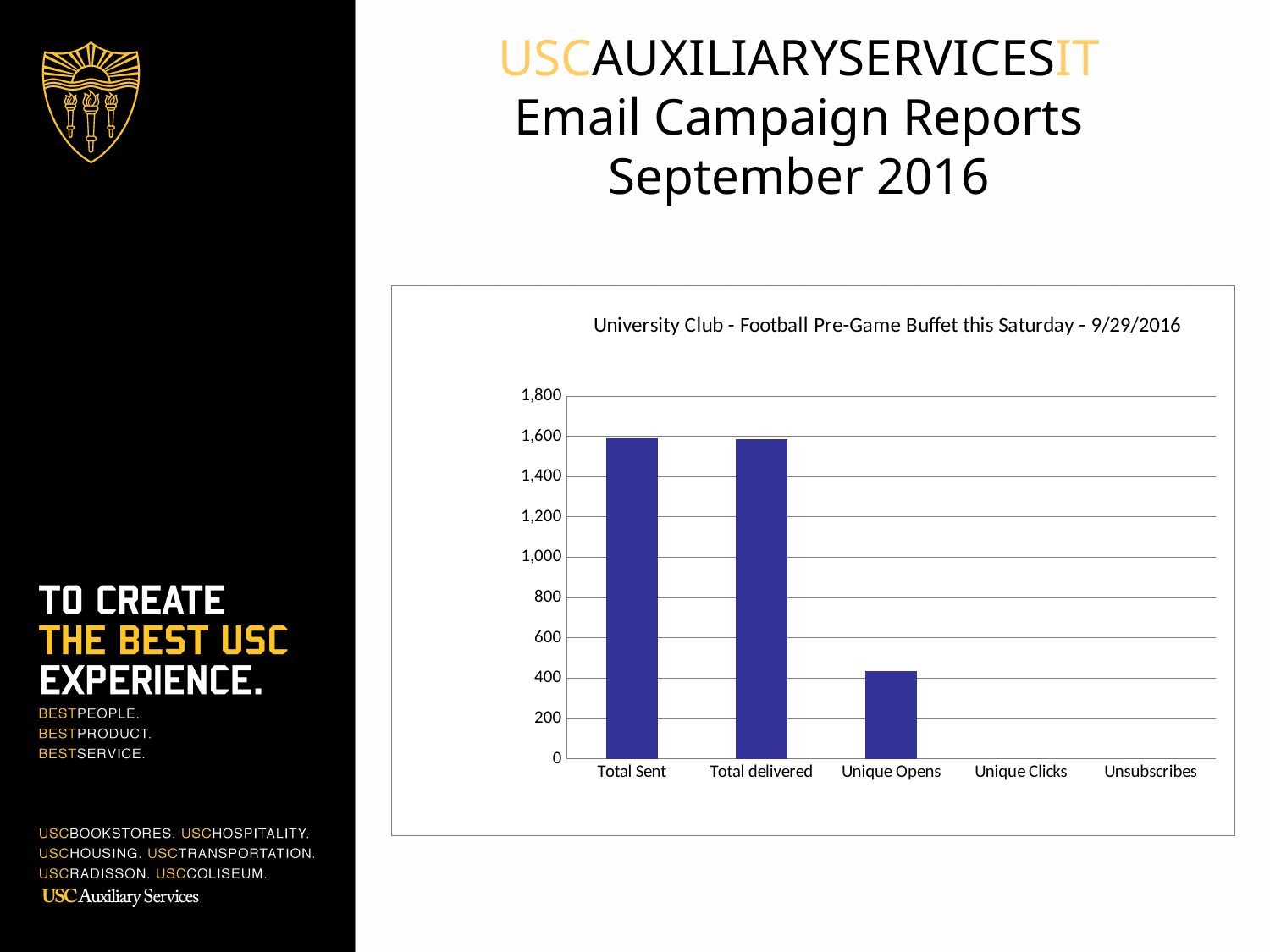
Do the values generally rise or fall moving from left to right along the x axis? fall What is the title of the chart? University Club - Football Pre-Game Buffet this Saturday - 9/29/2016 Is the value for Total Sent greater or less than 1,400? greater How many categories are shown on the x axis of the chart? 5 Is the value for Unique Clicks greater or less than 200? less What is the highest value shown on the vertical axis of the chart? 1,800 What kind of chart is shown on the slide? Bar chart Which is larger, the value for Total Sent or the value for Unique Opens? Total Sent Which is larger, the value for Unique Opens or the value for Unsubscribes? Unique Opens Is the value for Unique Opens greater or less than 200? greater